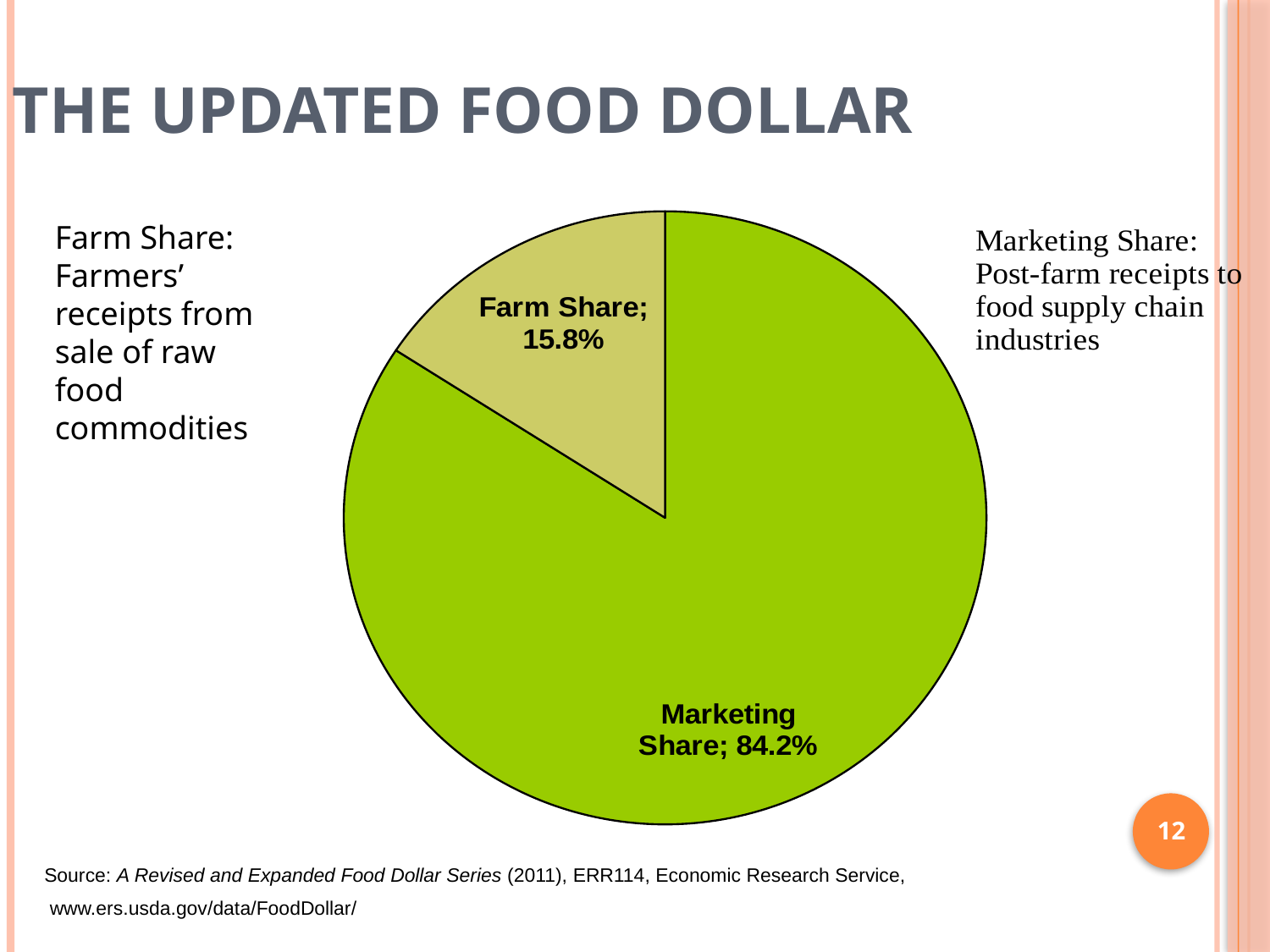
What is the title of the slide containing the pie chart? THE UPDATED FOOD DOLLAR What share of the pie does the Farm Share slice represent? 15.8% Which is larger, Farm Share or Marketing Share? Marketing Share How many slices does the pie chart have? 2 Which slice of the pie is the smallest? Farm Share What is the difference between the Marketing Share and the Farm Share? 68.4% Which slice of the pie is the largest? Marketing Share What colour is the Marketing Share slice? green What kind of chart is shown on the slide? pie chart What is the value shown for Farm Share? 15.8% What is the value shown for Marketing Share? 84.2%